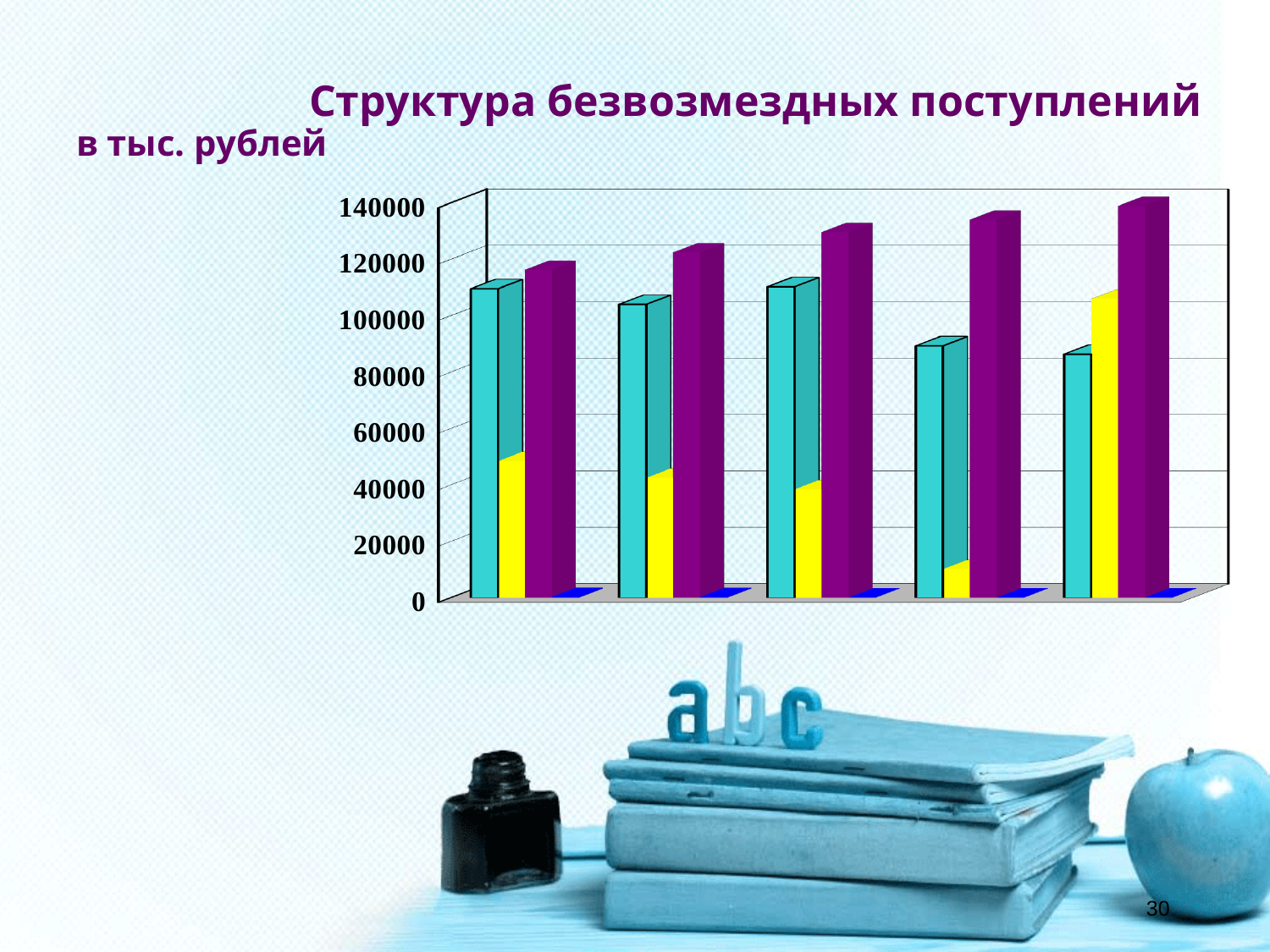
How many groups of bars are plotted along the x axis? 5 How many bars are there in each group? 4 What is the title of the chart on the slide? Структура безвозмездных поступлений In the first group, which is larger: the cyan bar or the yellow bar? the cyan bar Is the yellow bar in the fifth (rightmost) group greater or less than 80000? greater Is the yellow bar in the fourth group greater or less than 20000? less Do the purple bars rise or fall from left to right across the groups? rise What kind of chart is shown on the slide? bar chart Which group has the tallest purple bar? the fifth (rightmost) group Is the cyan bar in the fifth (rightmost) group greater or less than 100000? less Which group has the shortest yellow bar? the fourth group